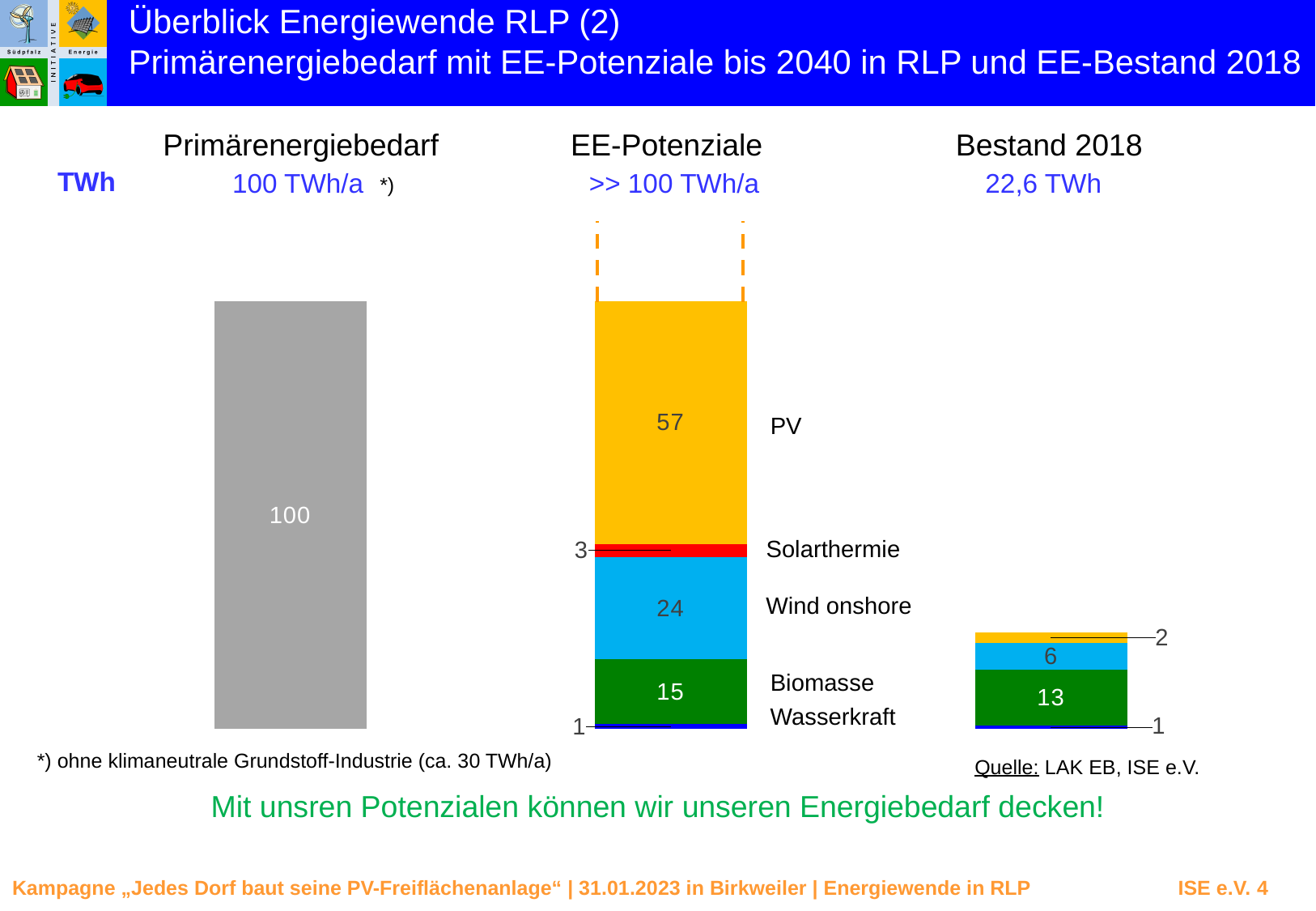
What is the total of the EE-Potenziale stacked bar (sum of its labelled segments)? 100 In the EE-Potenziale bar, what is the value for PV? 57 Which segment of the EE-Potenziale bar is the smallest? Wasserkraft In the EE-Potenziale bar, which is larger: Biomasse or Wind onshore? Wind onshore In the EE-Potenziale bar, what is the value for Solarthermie? 3 What total value is given for Bestand 2018 above its bar? 22,6 TWh In the EE-Potenziale bar, what is the value for Wasserkraft? 1 In the EE-Potenziale bar, what is the value for Wind onshore? 24 Which segment of the EE-Potenziale bar is the largest? PV In the EE-Potenziale bar, how much larger is PV than Wind onshore? 33 What value is printed on the Primärenergiebedarf bar? 100 What kind of chart is shown on the slide? Stacked bar chart